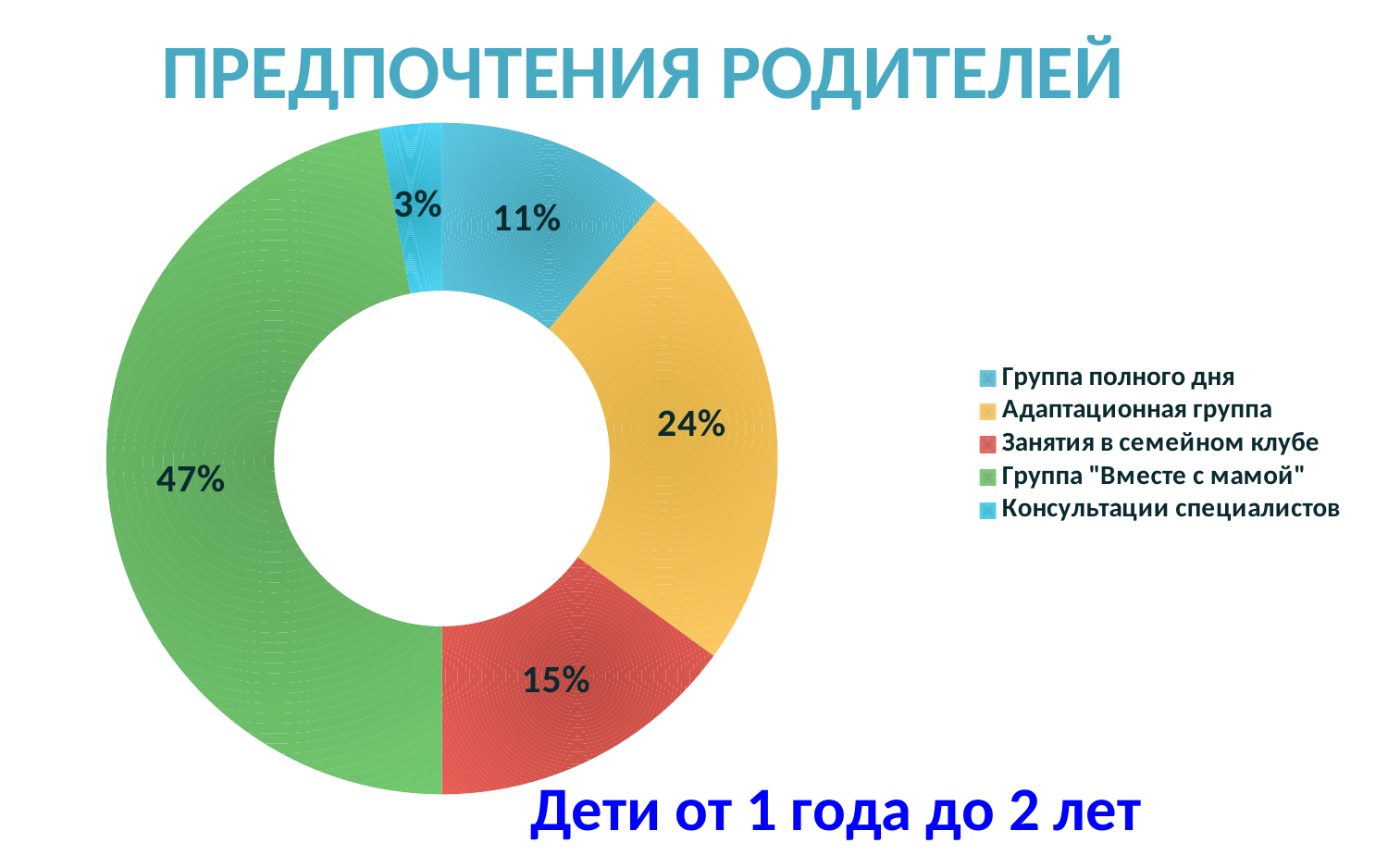
What share of the chart does Группа "Вместе с мамой" account for? 47% What is the title of the chart? ПРЕДПОЧТЕНИЯ РОДИТЕЛЕЙ What is the value for Адаптационная группа? 24% Which is larger, Группа полного дня or Занятия в семейном клубе? Занятия в семейном клубе What is the value for Группа полного дня? 11% How many categories does the chart show? 5 What is the value for Консультации специалистов? 3% What is the difference between the shares of Адаптационная группа and Занятия в семейном клубе? 9% What kind of chart is shown on the slide? Pie chart (doughnut) Which category has the largest share? Группа "Вместе с мамой" Which category has the smallest share? Консультации специалистов What is the value for Занятия в семейном клубе? 15%